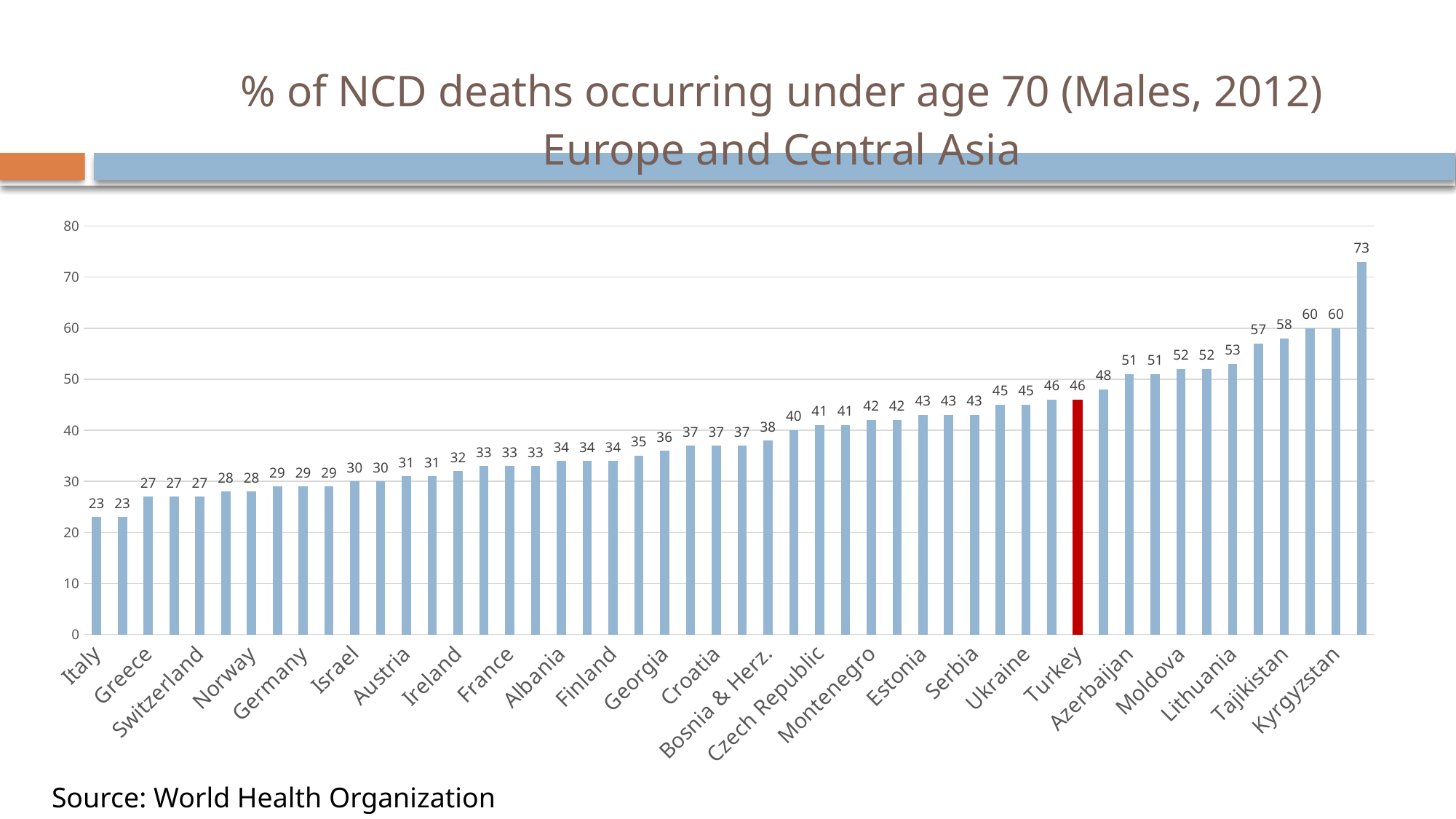
Is the value for Italy greater or less than 30? less What is the difference between the value for Turkey and the value for Italy? 23 What is the value for Italy? 23 Which country is highlighted with a red bar? Turkey Which has a larger value, Turkey or Italy? Turkey What is the highest value shown in the chart? 73 What type of chart is shown on the slide? bar chart What is the lowest value shown in the chart? 23 Do the values generally rise or fall from left to right along the x axis? rise What is the value for Turkey, the red bar? 46 What is the source cited for the chart? World Health Organization Is the value for Turkey greater or less than 40? greater